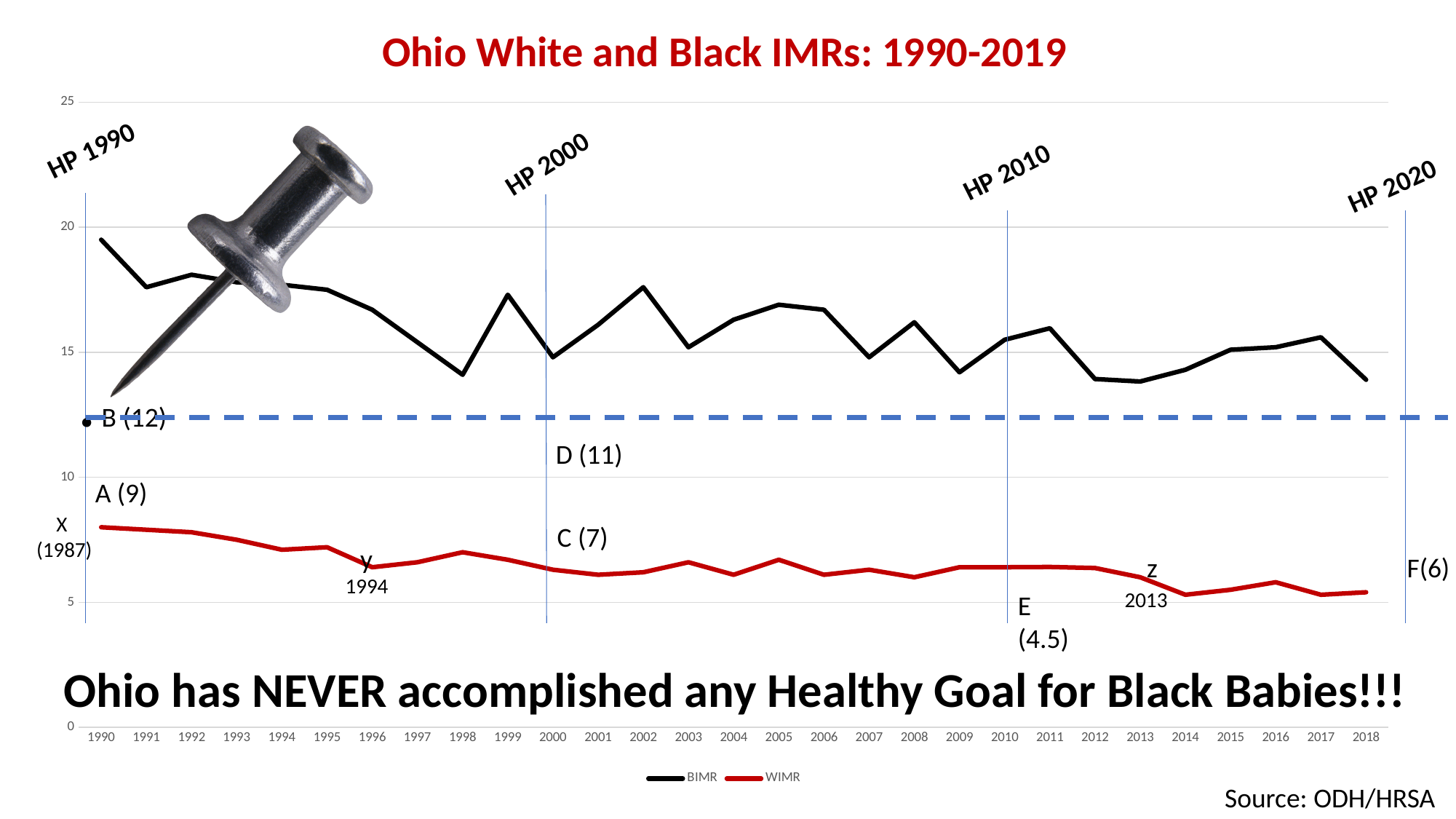
In which year is the BIMR series at its highest? 1990 What are the two series named in the legend? BIMR and WIMR Does the WIMR series generally rise or fall from 1990 to 2018? fall What kind of chart is shown on the slide? line chart Is the WIMR value for 1990 greater or less than 10? less Which series has the higher value in 2010, BIMR or WIMR? BIMR What is the title of the chart? Ohio White and Black IMRs: 1990-2019 Is the BIMR value for 2002 greater or less than 15? greater Is the WIMR value for 2018 greater or less than 10? less How many series does the legend list? 2 How many years are shown on the x axis? 29